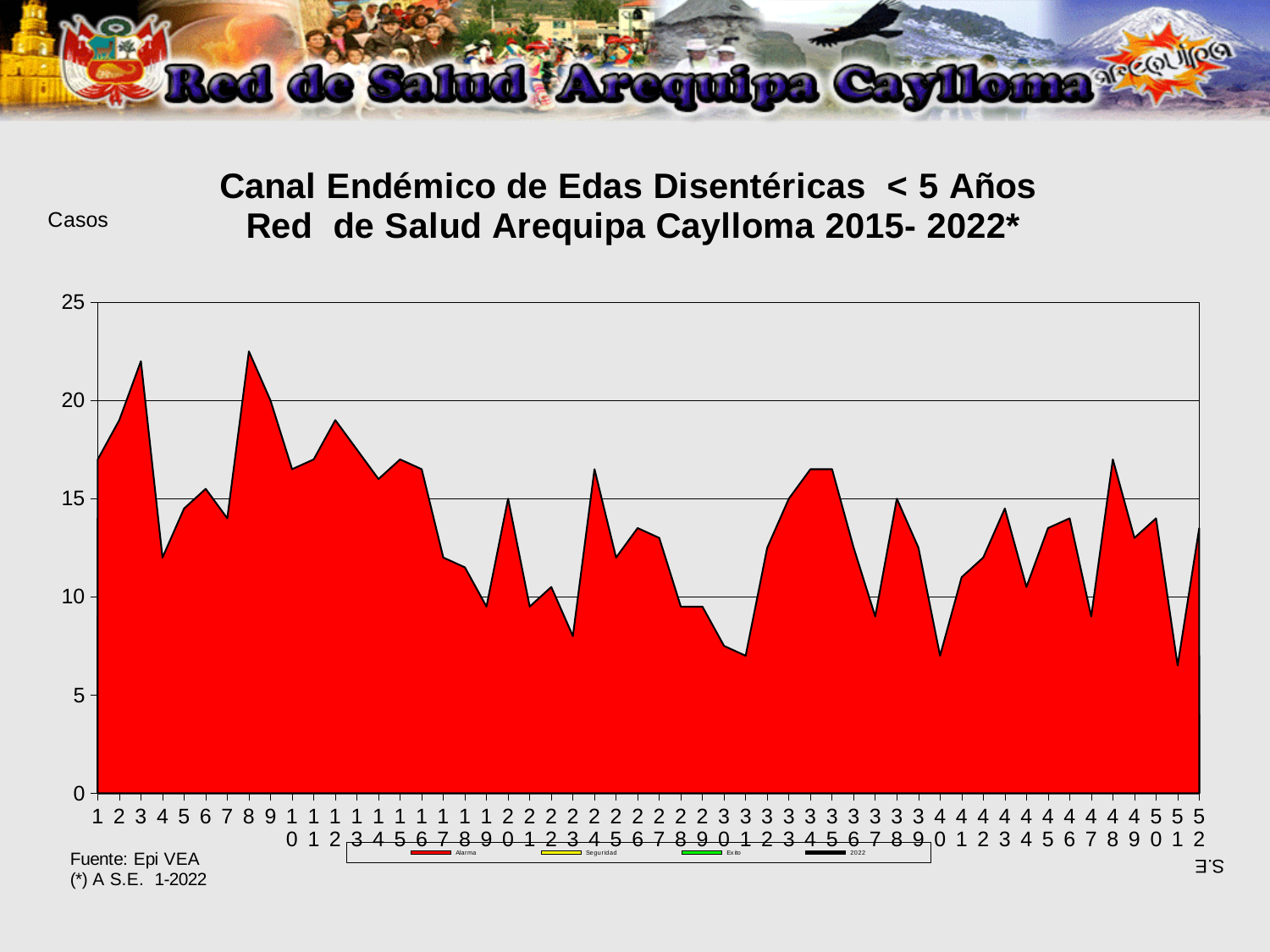
Is the value for week 8 greater or less than 20? greater What is the highest value shown on the y axis? 25 Is the value for week 1 greater or less than 15? greater What is the label on the y axis of the chart? Casos How many entries does the legend list? 4 Is the value for week 51 greater or less than 10? less Do the values rise or fall from week 8 to week 10? fall What kind of chart is shown on the slide? Area chart How many epidemiological weeks (S.E.) are plotted along the x axis? 52